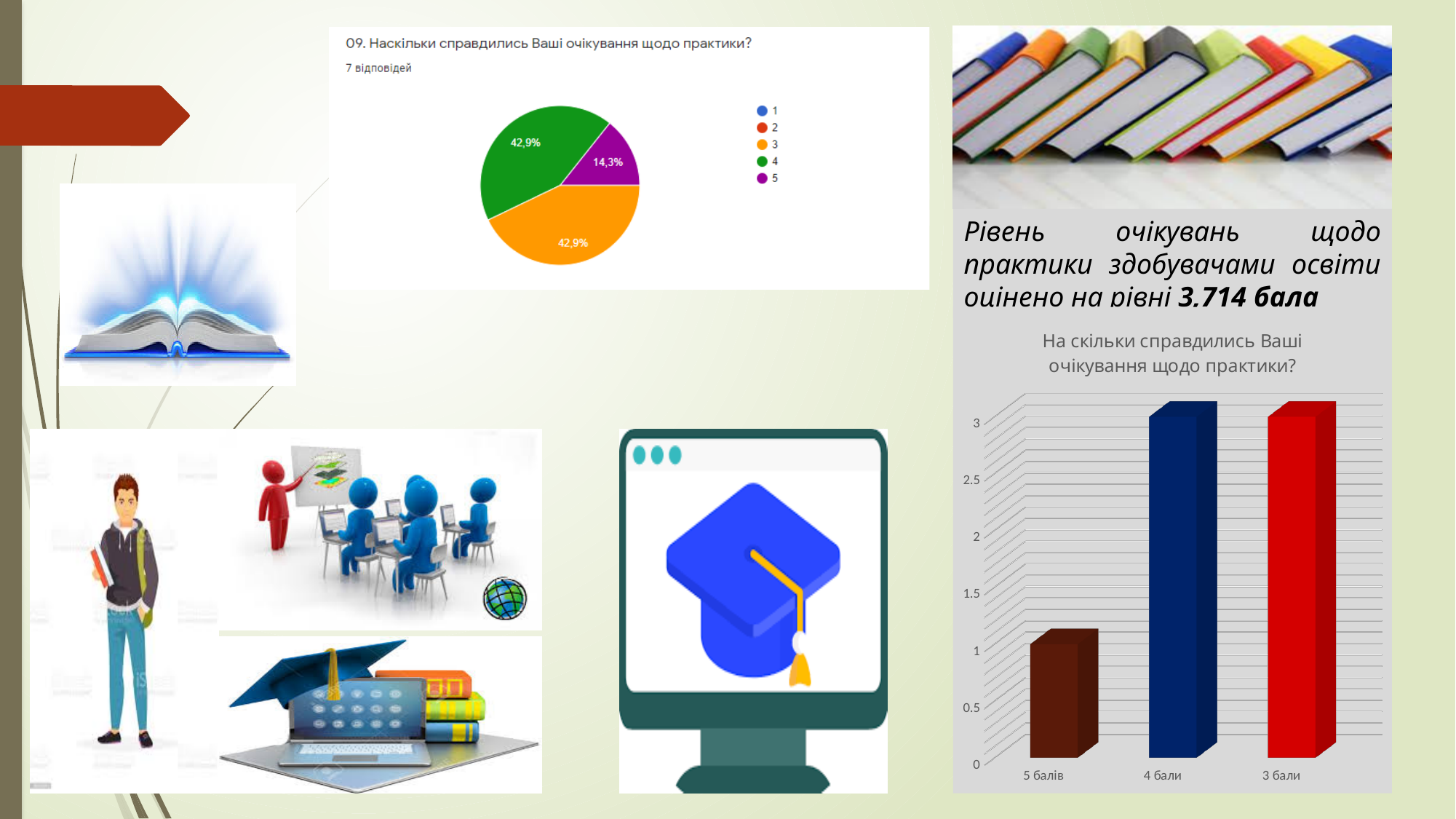
In the bar chart on the right, which category has the lowest value? 5 балів In the pie chart on the left, which slice is the smallest? 5 How many entries does the legend of the pie chart on the left list? 5 How many responses does the pie chart on the left report? 7 відповідей In the bar chart on the right, is the value for 5 балів greater or less than 2? less What kind of chart is the chart on the right titled "На скільки справдились Ваші очікування щодо практики?"? bar chart In the pie chart on the left, what share of responses does the slice for 4 have? 42,9% How many categories does the bar chart on the right show? 3 In the pie chart on the left, which slice is larger, 4 or 5? 4 In the pie chart on the left, what is the difference in percentage points between the slice for 3 and the slice for 5? 28,6% In the pie chart on the left, what share of responses does the slice for 5 have? 14,3% What kind of chart is the chart on the left titled "09. Наскільки справдились Ваші очікування щодо практики?"? pie chart